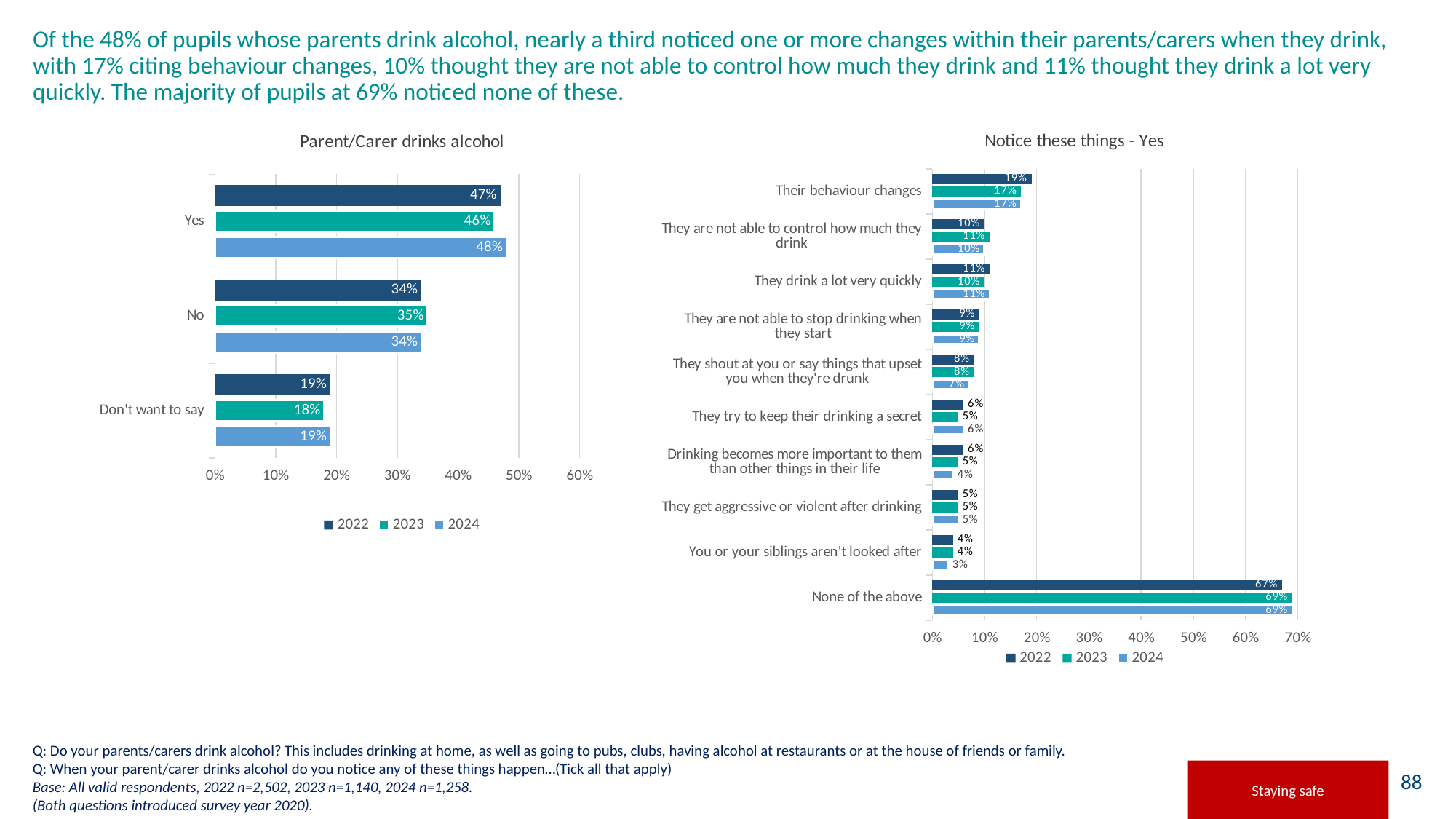
How many series does the legend of the 'Parent/Carer drinks alcohol' chart list? 3 In the 'Notice these things - Yes' chart, what is the value for 'Their behaviour changes' in 2022? 19% In the 'Notice these things - Yes' chart, what is the value for 'None of the above' in 2024? 69% What type of chart is the 'Notice these things - Yes' chart? Bar chart In the 'Parent/Carer drinks alcohol' chart, what is the difference between 'Yes' and 'No' in 2022? 13% In the 'Parent/Carer drinks alcohol' chart, which category has the highest value in 2024? Yes In the 'Notice these things - Yes' chart, how many categories are shown? 10 In the 'Parent/Carer drinks alcohol' chart, what is the value for 'Don't want to say' in 2022? 19% In the 'Parent/Carer drinks alcohol' chart, what is the value for 'Yes' in 2024? 48% In the 'Notice these things - Yes' chart, what is the value for 'You or your siblings aren't looked after' in 2024? 3% In the 'Notice these things - Yes' chart, which category has the lowest value in 2024? You or your siblings aren't looked after In the 'Parent/Carer drinks alcohol' chart, what is the value for 'No' in 2023? 35%